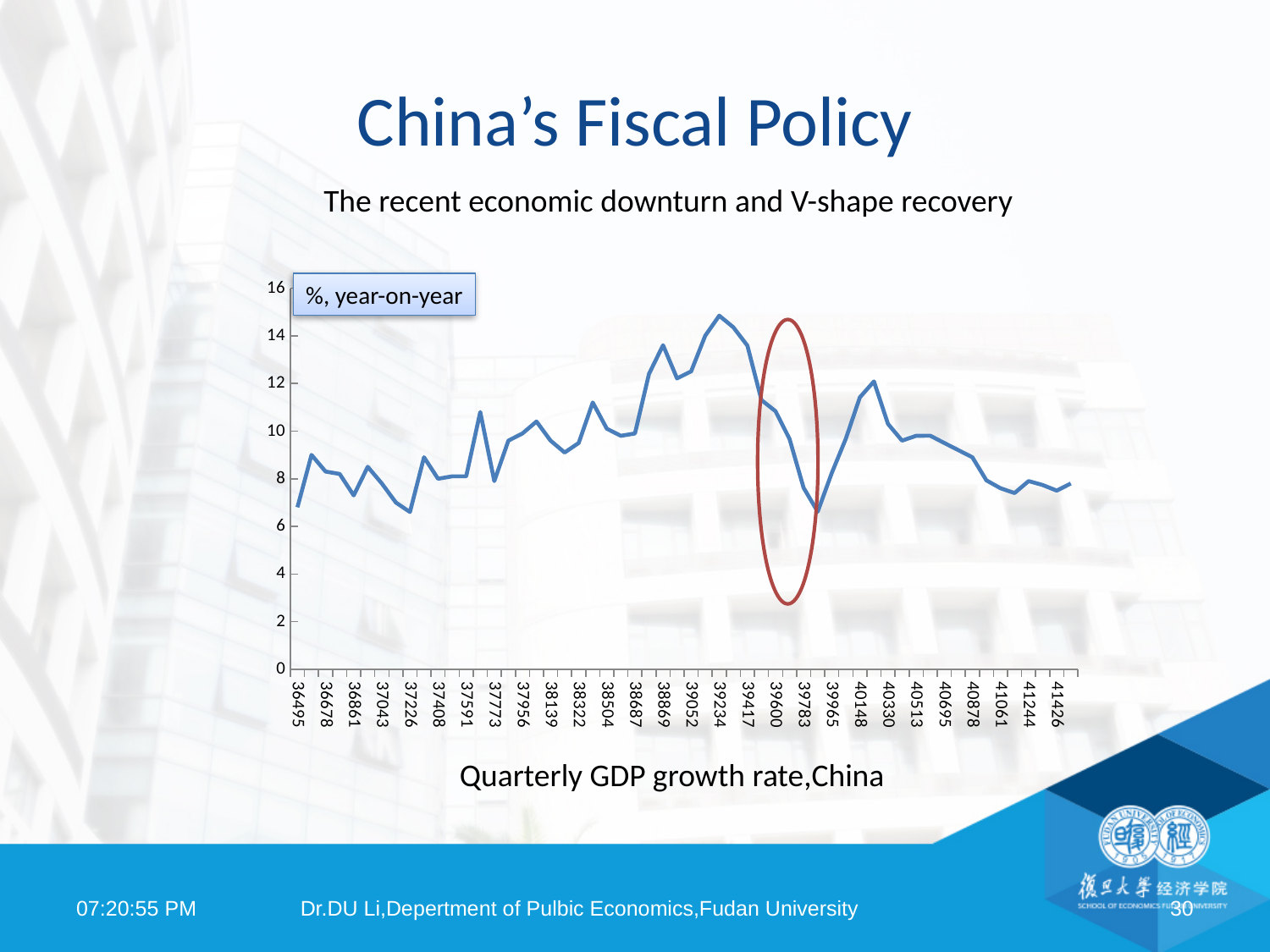
Do the values rise or fall between x-axis labels 39234 and 39783? fall Which is larger, the value at x-axis label 39234 or the value at x-axis label 39783? 39234 Do the values rise or fall between x-axis labels 39783 and 40148? rise What caption is shown below the chart? Quarterly GDP growth rate,China Is the value at x-axis label 39783 greater or less than 8? less Is the value at x-axis label 40148 greater or less than 10? greater What unit label is shown in the box at the top left of the chart? %, year-on-year Is the value at x-axis label 39234 greater or less than 12? greater What kind of chart is shown on the slide? line chart